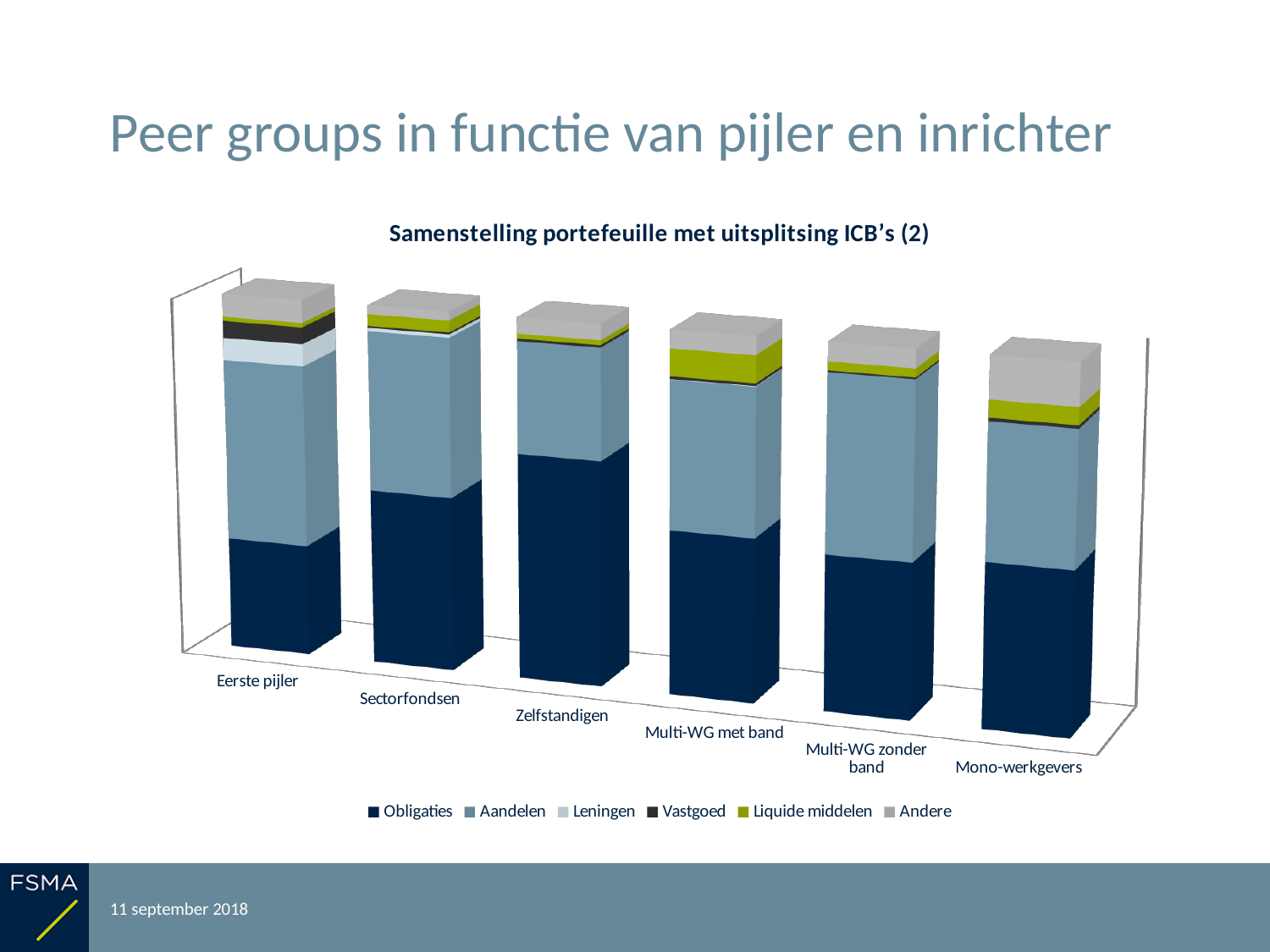
Which category has the largest Obligaties segment? Zelfstandigen Which category has the largest Liquide middelen segment? Multi-WG met band How many series does the chart legend list? 6 Is the Aandelen segment larger for Eerste pijler or for Mono-werkgevers? Eerste pijler How many categories are shown along the x axis of the chart? 6 Is the Obligaties segment larger for Zelfstandigen or for Eerste pijler? Zelfstandigen Which series is listed first in the chart legend? Obligaties Which category has the smallest Obligaties segment? Eerste pijler What kind of chart is shown on the slide? Stacked bar chart What is the title of the chart? Samenstelling portefeuille met uitsplitsing ICB's (2) Which category has the largest Aandelen segment? Eerste pijler